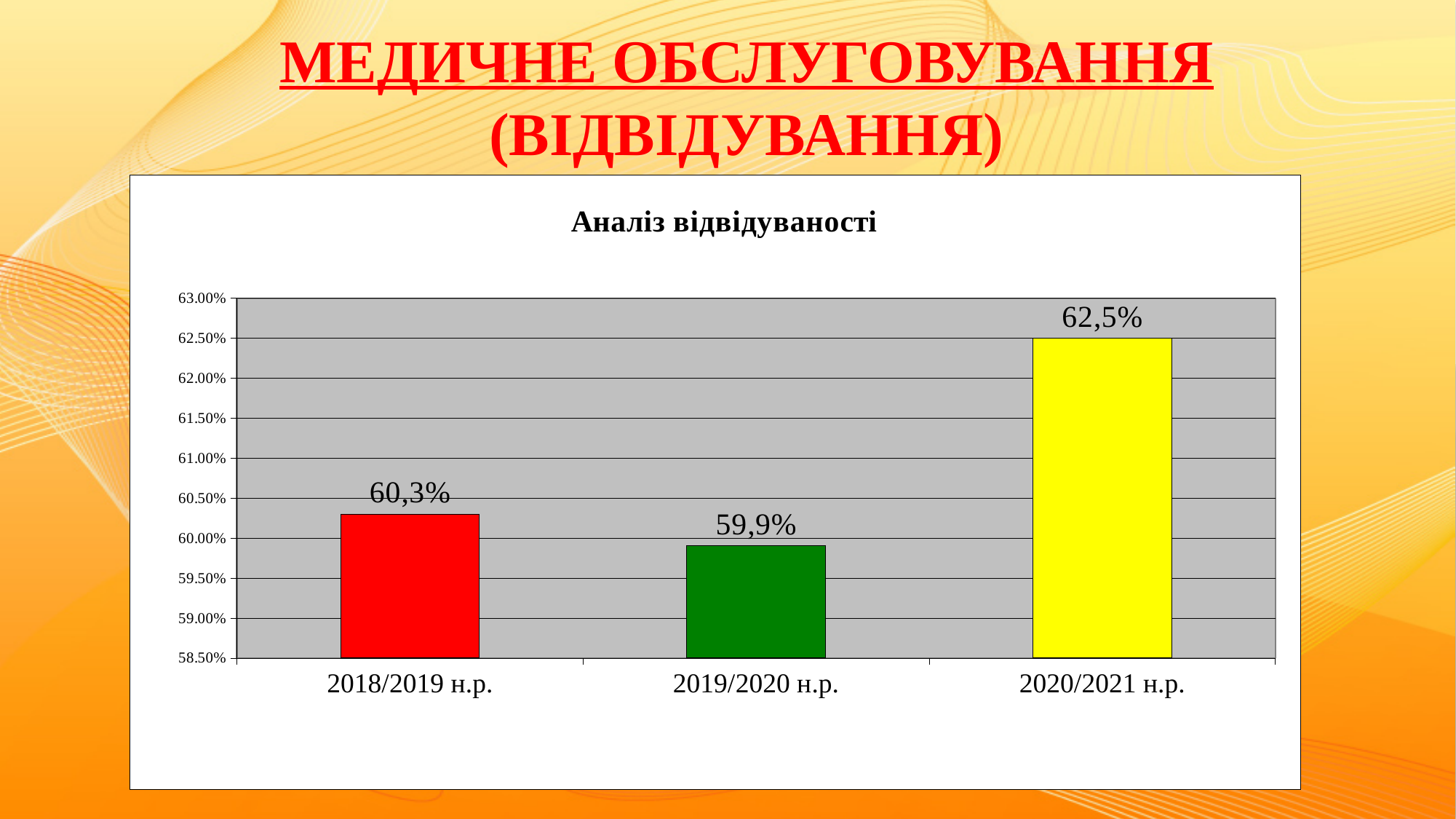
What is the title of the chart? Аналіз відвідуваності Is the value for 2020/2021 н.р. greater or less than 62.00%? greater What kind of chart is shown on the slide? bar chart How many categories are shown on the x axis? 3 Which is larger, the value for 2018/2019 н.р. or 2019/2020 н.р.? 2018/2019 н.р. What is the value for 2020/2021 н.р.? 62,5% What is the difference between the values for 2018/2019 н.р. and 2019/2020 н.р.? 0,4% Which year has the highest value? 2020/2021 н.р. Which year has the lowest value? 2019/2020 н.р. What is the difference between the values for 2020/2021 н.р. and 2018/2019 н.р.? 2,2% What is the value for 2018/2019 н.р.? 60,3% What is the value for 2019/2020 н.р.? 59,9%